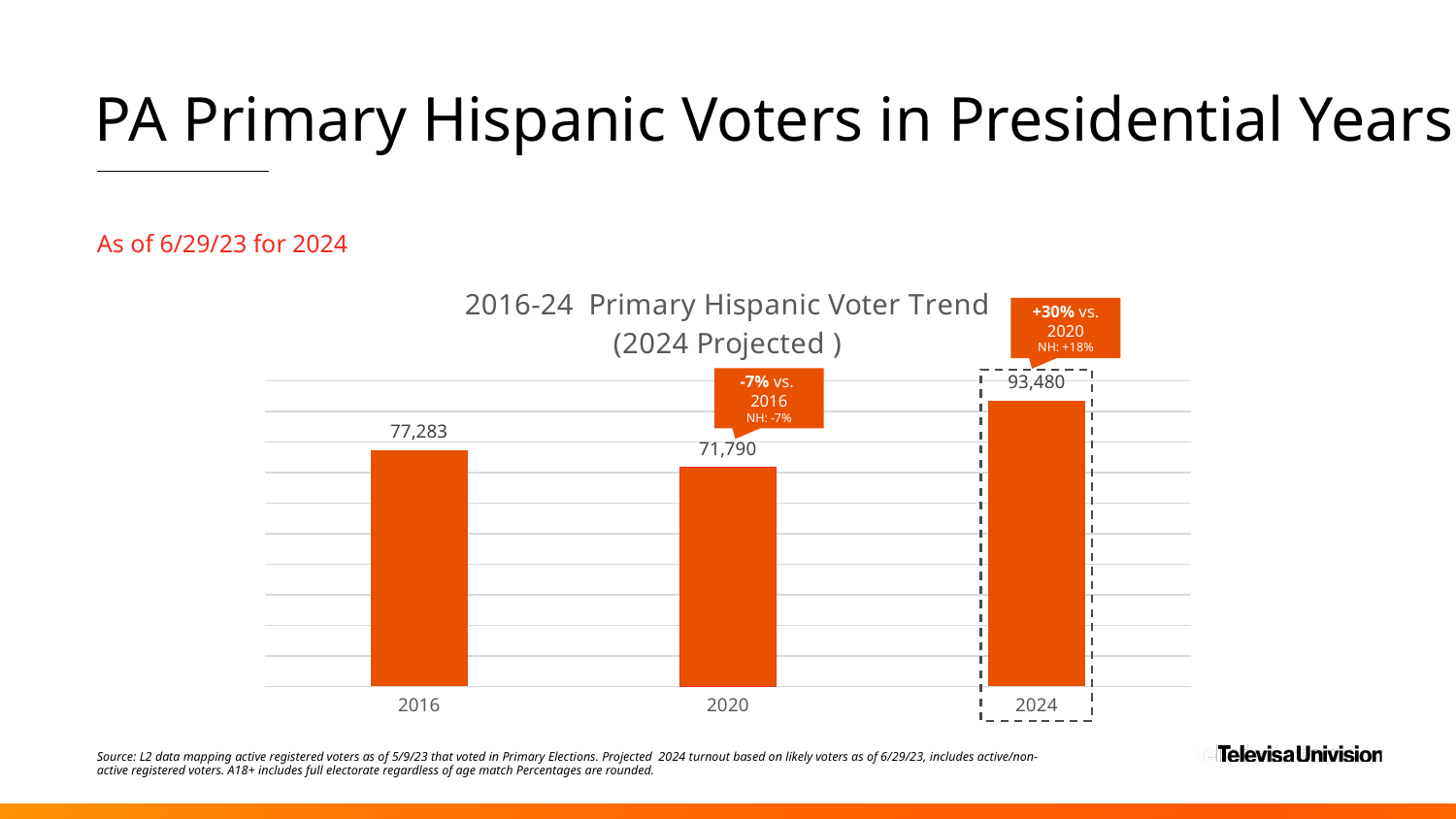
Does the value rise or fall from 2020 to 2024? Rise What is the title of the chart? 2016-24 Primary Hispanic Voter Trend (2024 Projected ) How many years are shown on the chart? 3 Which is larger, the value for 2016 or the value for 2020? 2016 What is the value for 2016? 77,283 Which year has the lowest value? 2020 What kind of chart is this? Bar chart Which year has the highest value? 2024 What is the value for 2020? 71,790 What is the difference between the 2016 and 2020 values? 5,493 What is the difference between the 2024 and 2020 values? 21,690 What is the projected value for 2024? 93,480